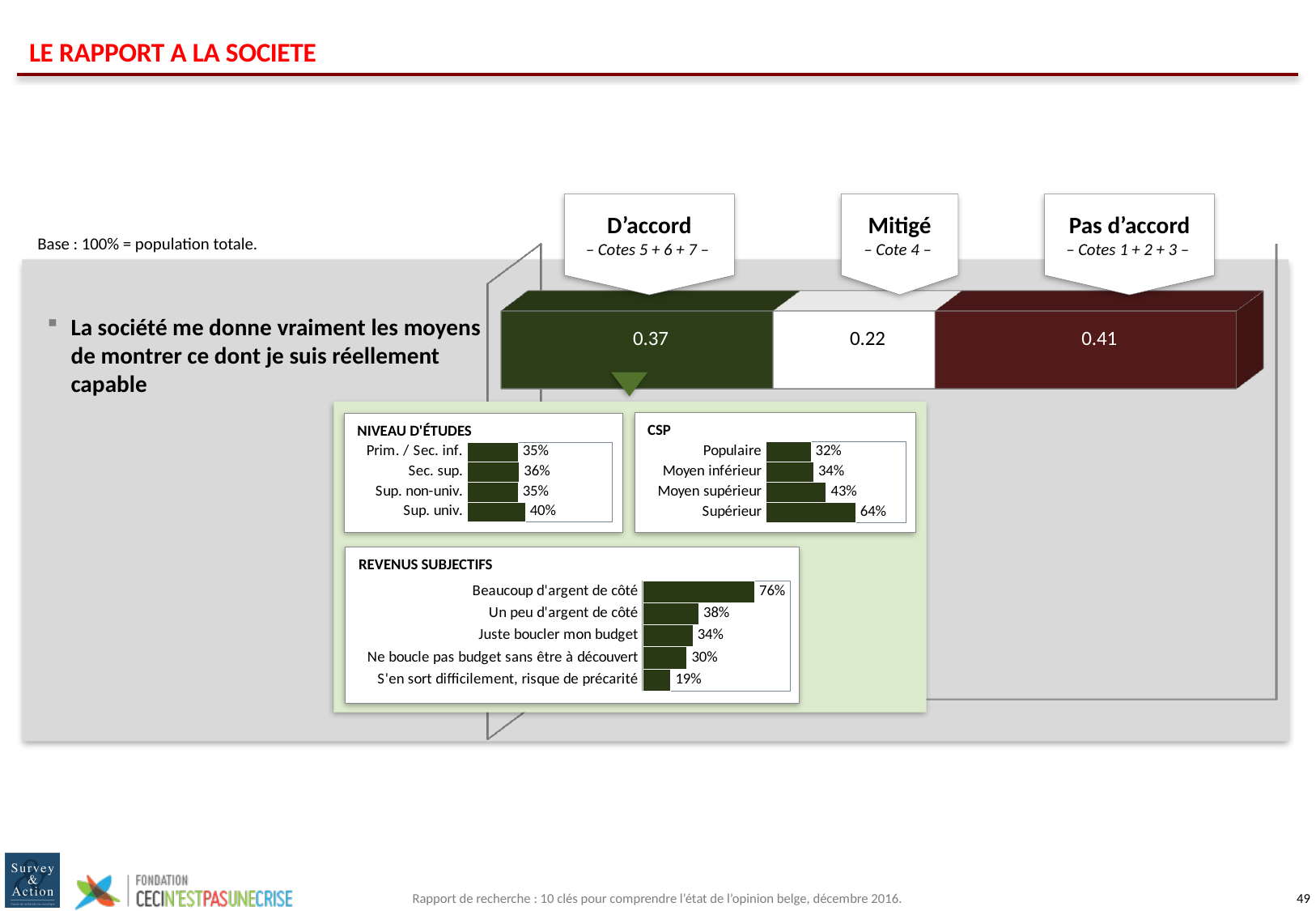
In the CSP chart, which category has the highest value? Supérieur In the main stacked bar, what is the difference between "Pas d'accord" and "D'accord"? 0.04 In the main stacked bar, what is the value for "Pas d'accord"? 0.41 In the main stacked bar, which segment is the smallest? Mitigé In the NIVEAU D'ÉTUDES chart, what is the value for "Sup. univ."? 40% In the CSP chart, what is the value for "Moyen supérieur"? 43% In the NIVEAU D'ÉTUDES chart, how many categories are shown? 4 In the CSP chart, what is the difference between "Supérieur" and "Populaire"? 32% In the main stacked bar, what is the value for "D'accord"? 0.37 What kind of chart is the REVENUS SUBJECTIFS chart? Bar chart In the REVENUS SUBJECTIFS chart, what is the value for "Beaucoup d'argent de côté"? 76% In the REVENUS SUBJECTIFS chart, which category has the lowest value? S'en sort difficilement, risque de précarité